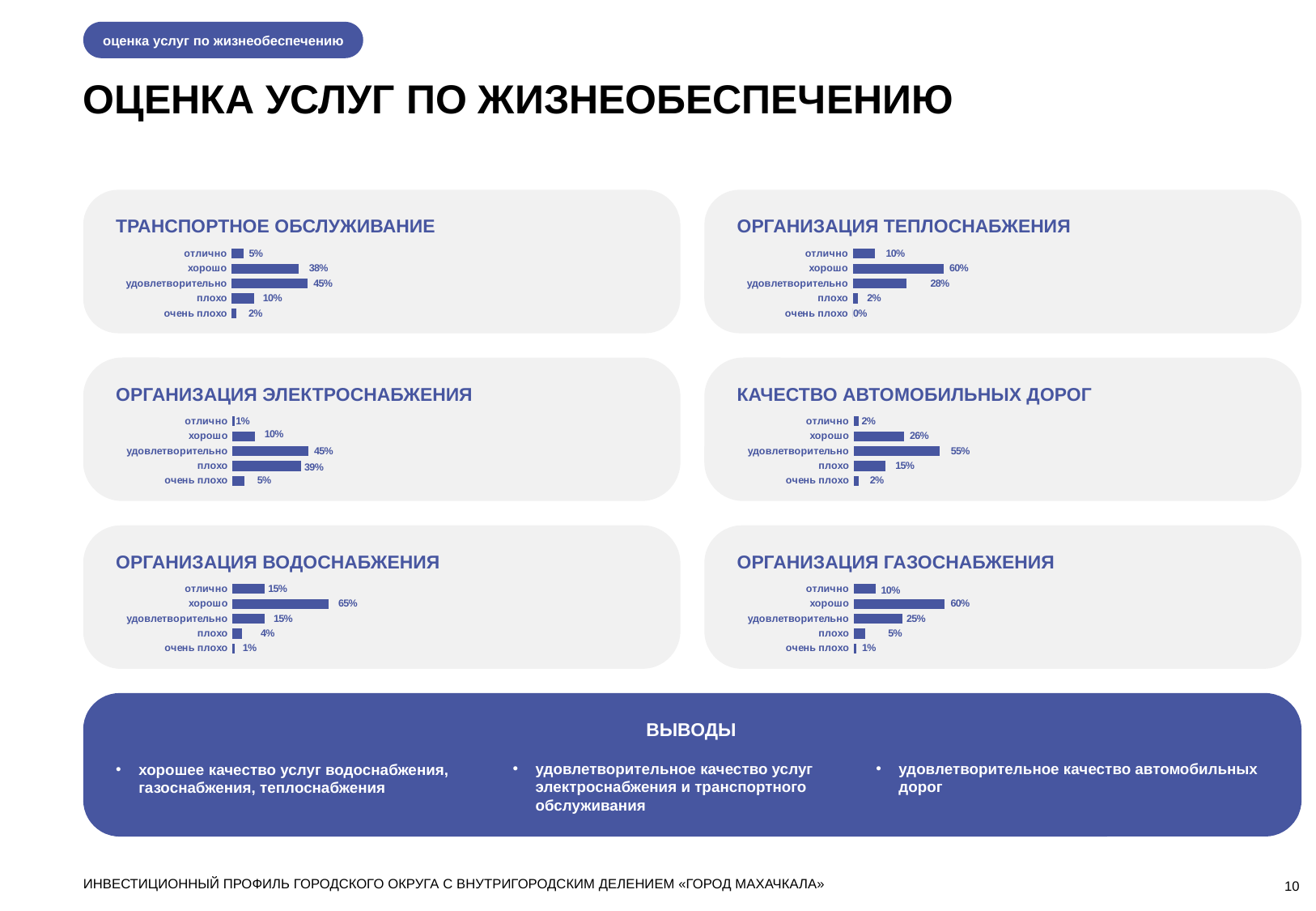
How many categories does the ОРГАНИЗАЦИЯ ГАЗОСНАБЖЕНИЯ chart show? 5 In the ОРГАНИЗАЦИЯ ЭЛЕКТРОСНАБЖЕНИЯ chart, what is the difference between удовлетворительно and плохо? 6% In the КАЧЕСТВО АВТОМОБИЛЬНЫХ ДОРОГ chart, which is larger: удовлетворительно or плохо? удовлетворительно In the КАЧЕСТВО АВТОМОБИЛЬНЫХ ДОРОГ chart, what is the value for хорошо? 26% In the ОРГАНИЗАЦИЯ ВОДОСНАБЖЕНИЯ chart, what is the value for хорошо? 65% In the ОРГАНИЗАЦИЯ ЭЛЕКТРОСНАБЖЕНИЯ chart, which category has the lowest value? отлично In the ТРАНСПОРТНОЕ ОБСЛУЖИВАНИЕ chart, what is the value for удовлетворительно? 45% In the ОРГАНИЗАЦИЯ ВОДОСНАБЖЕНИЯ chart, what is the difference between хорошо and отлично? 50% In the ОРГАНИЗАЦИЯ ТЕПЛОСНАБЖЕНИЯ chart, which category has the highest value? хорошо In the ОРГАНИЗАЦИЯ ГАЗОСНАБЖЕНИЯ chart, what is the value for удовлетворительно? 25% In the ОРГАНИЗАЦИЯ ТЕПЛОСНАБЖЕНИЯ chart, what is the value for очень плохо? 0% What type of chart is the ТРАНСПОРТНОЕ ОБСЛУЖИВАНИЕ chart? Bar chart